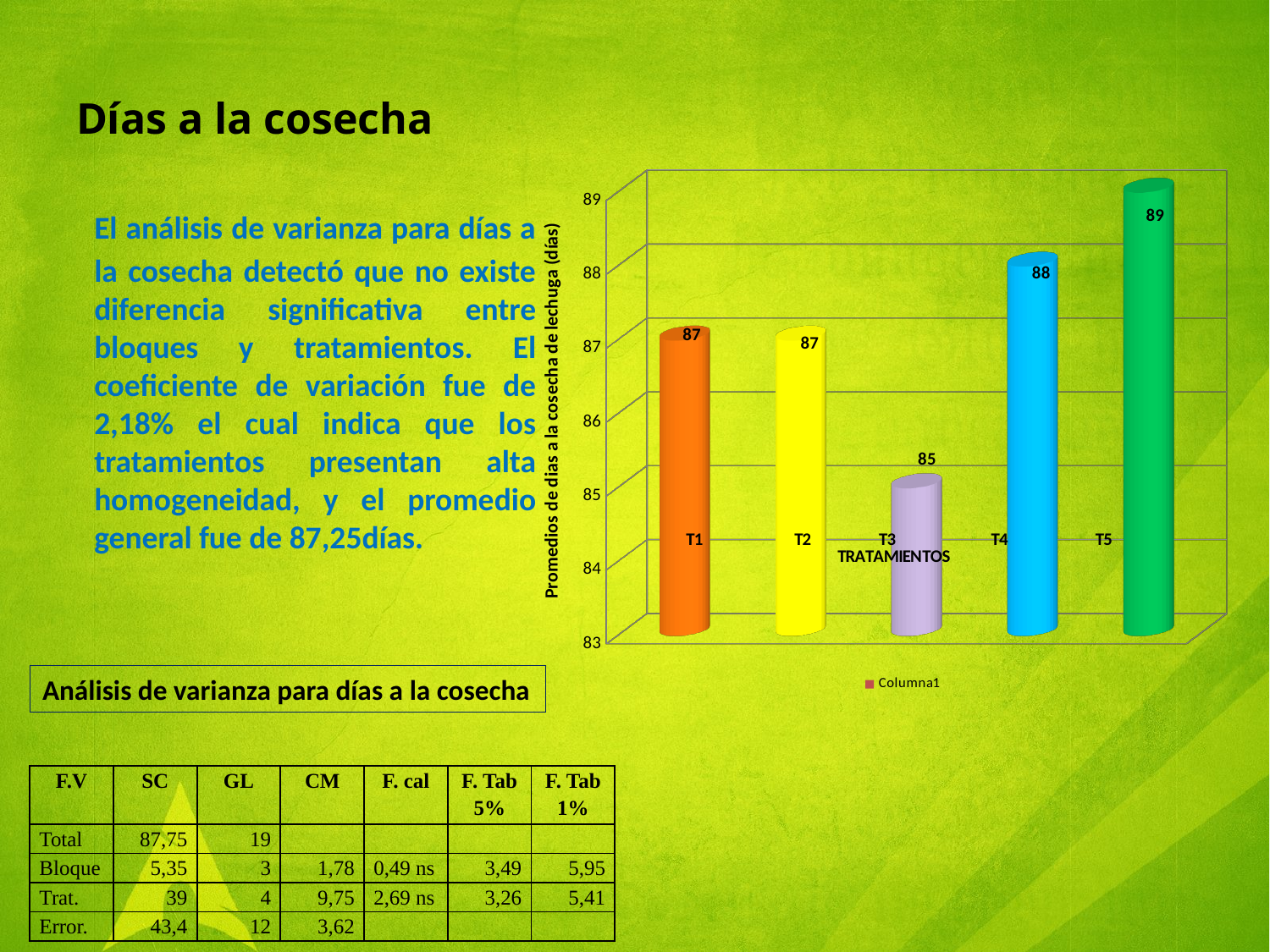
Which is larger, the value for T4 or the value for T1? T4 What is the value for T5? 89 What is the value for T4? 88 What kind of chart is shown on the slide? bar chart What is the difference between the values for T5 and T3? 4 Which treatment has the highest value? T5 What is the value for T3? 85 What is the label of the x axis of the chart? TRATAMIENTOS Which treatment has the lowest value? T3 How many treatments are shown on the x axis? 5 Is the value for T3 greater or less than 86? less How many series does the legend list? 1